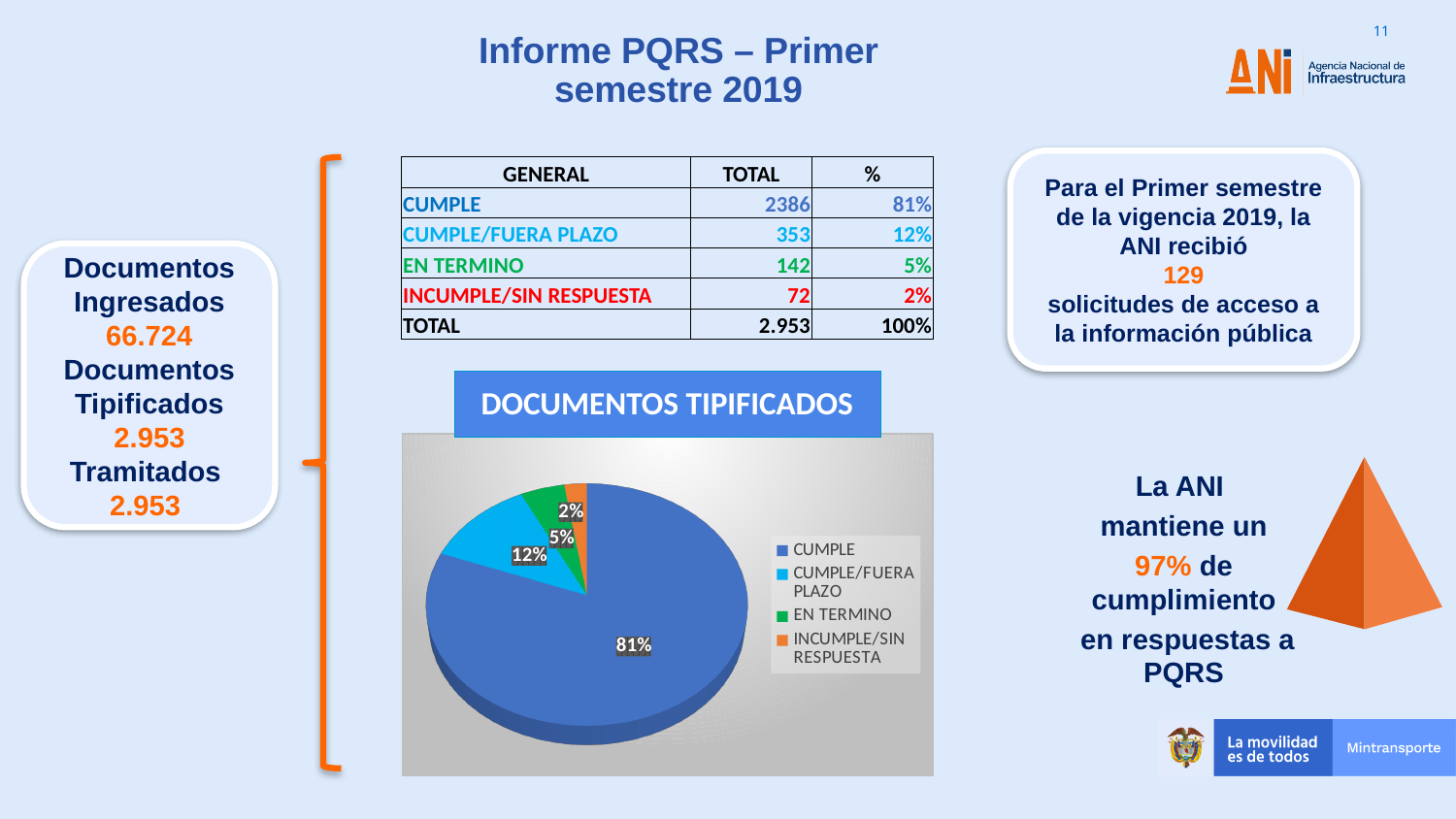
In the DOCUMENTOS TIPIFICADOS pie chart, what is the difference in percentage points between CUMPLE and CUMPLE/FUERA PLAZO? 69 In the DOCUMENTOS TIPIFICADOS pie chart, which is larger: EN TERMINO or INCUMPLE/SIN RESPUESTA? EN TERMINO In the DOCUMENTOS TIPIFICADOS pie chart, what share does CUMPLE/FUERA PLAZO have? 12% In the DOCUMENTOS TIPIFICADOS pie chart, what share does CUMPLE have? 81% Which category has the largest slice in the DOCUMENTOS TIPIFICADOS pie chart? CUMPLE What kind of chart is shown under the heading DOCUMENTOS TIPIFICADOS? Pie chart In the DOCUMENTOS TIPIFICADOS pie chart, what share does EN TERMINO have? 5% How many entries does the legend of the DOCUMENTOS TIPIFICADOS pie chart list? 4 How many slices does the DOCUMENTOS TIPIFICADOS pie chart have? 4 What colour is the CUMPLE slice in the DOCUMENTOS TIPIFICADOS pie chart? Blue Which category has the smallest slice in the DOCUMENTOS TIPIFICADOS pie chart? INCUMPLE/SIN RESPUESTA In the DOCUMENTOS TIPIFICADOS pie chart, what share does INCUMPLE/SIN RESPUESTA have? 2%